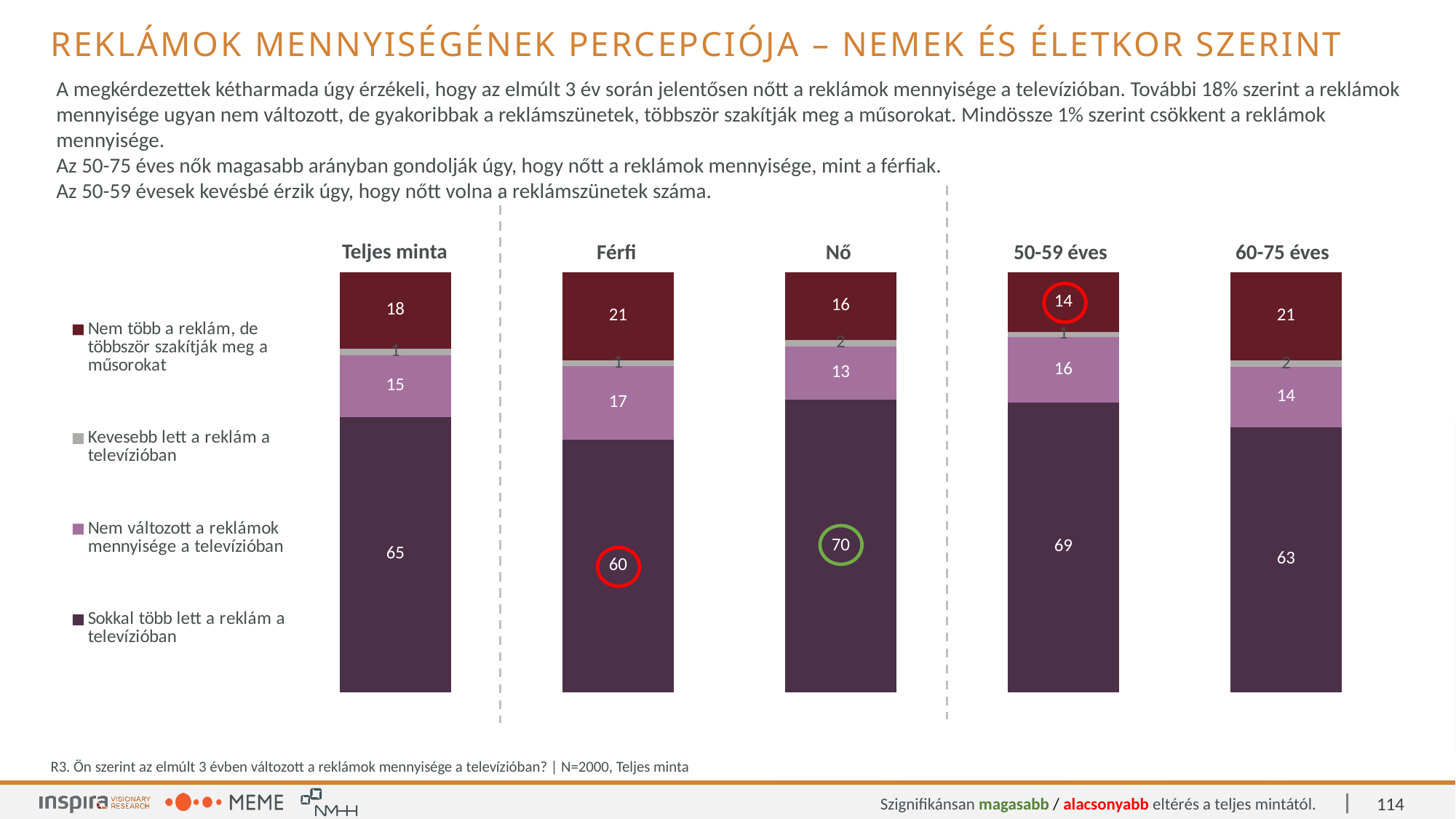
What is the value for "Sokkal több lett a reklám a televízióban" in the Teljes minta bar? 65 How many series does the legend list? 4 Which is larger: the "Nem változott a reklámok mennyisége a televízióban" value for 50-59 éves or for 60-75 éves? 50-59 éves What is the value for "Nem több a reklám, de többször szakítják meg a műsorokat" in the Férfi bar? 21 What is the difference between the Nő and Férfi values for "Sokkal több lett a reklám a televízióban"? 10 What is the value for "Kevesebb lett a reklám a televízióban" in the 60-75 éves bar? 2 What is the total of the 50-59 éves stacked bar? 100 What is the value for "Nem változott a reklámok mennyisége a televízióban" in the Nő bar? 13 Which group has the lowest value for "Nem több a reklám, de többször szakítják meg a műsorokat"? 50-59 éves What kind of chart is shown on the slide? Stacked bar chart Which group has the highest value for "Sokkal több lett a reklám a televízióban"? Nő How many groups (bars) are shown in the chart? 5